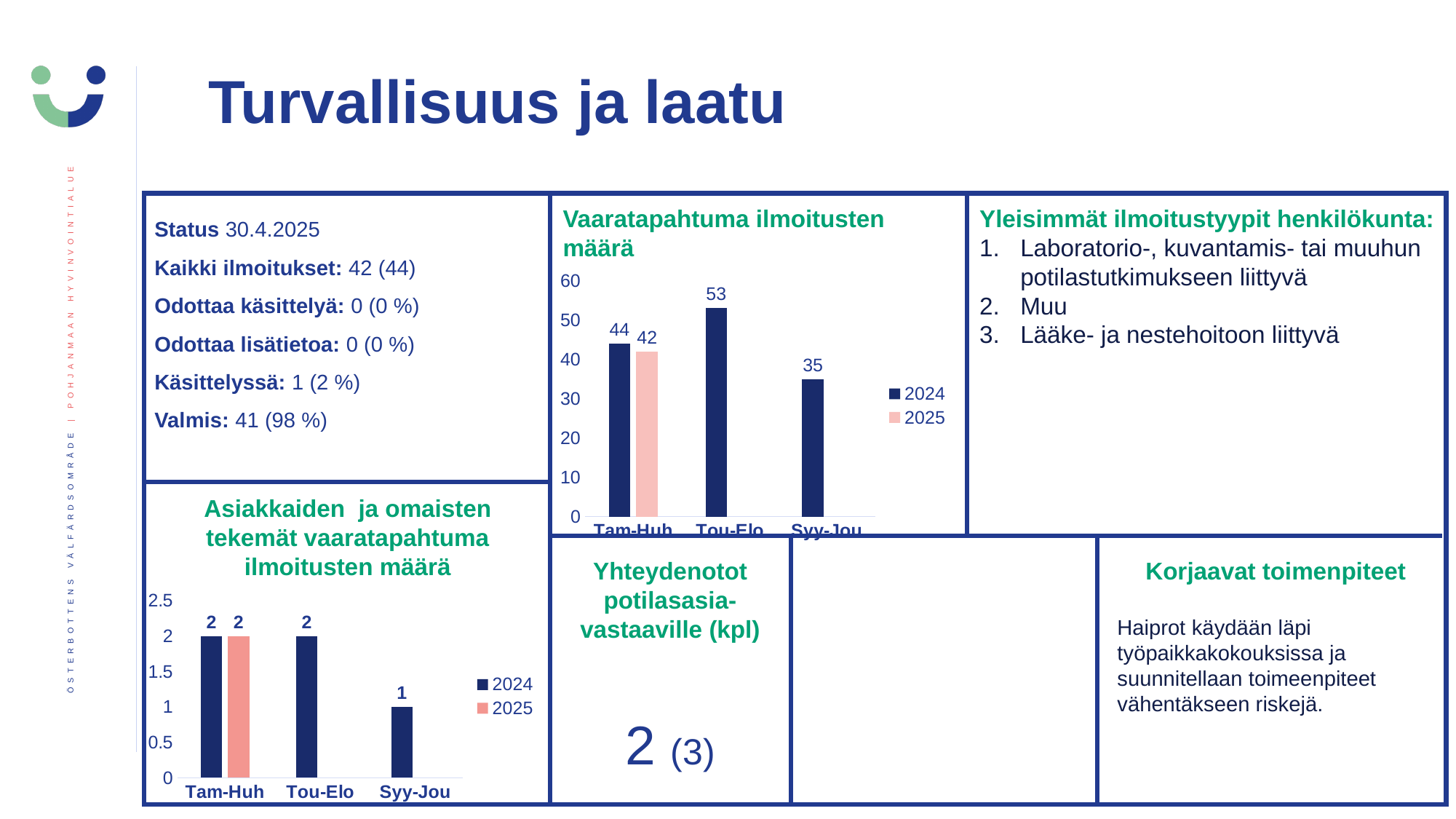
In the chart 'Vaaratapahtuma ilmoitusten määrä', which period has the lowest 2024 value? Syy-Jou What kind of chart is 'Vaaratapahtuma ilmoitusten määrä'? bar chart In the chart 'Asiakkaiden ja omaisten tekemät vaaratapahtuma ilmoitusten määrä', what is the 2024 value for Syy-Jou? 1 In the chart 'Vaaratapahtuma ilmoitusten määrä', which period has the highest 2024 value? Tou-Elo In the chart 'Vaaratapahtuma ilmoitusten määrä', what is the difference between the 2024 and 2025 values for Tam-Huh? 2 In the chart 'Asiakkaiden ja omaisten tekemät vaaratapahtuma ilmoitusten määrä', how many periods are shown on the x axis? 3 In the chart 'Vaaratapahtuma ilmoitusten määrä', how many series does the legend list? 2 In the chart 'Asiakkaiden ja omaisten tekemät vaaratapahtuma ilmoitusten määrä', what is the 2025 value for Tam-Huh? 2 In the chart 'Vaaratapahtuma ilmoitusten määrä', what is the 2025 value for Tam-Huh? 42 In the chart 'Vaaratapahtuma ilmoitusten määrä', is the 2024 value for Tou-Elo greater or less than 50? greater In the chart 'Asiakkaiden ja omaisten tekemät vaaratapahtuma ilmoitusten määrä', which is larger: the 2024 value for Tou-Elo or for Syy-Jou? Tou-Elo In the chart 'Vaaratapahtuma ilmoitusten määrä', what is the 2024 value for Tou-Elo? 53